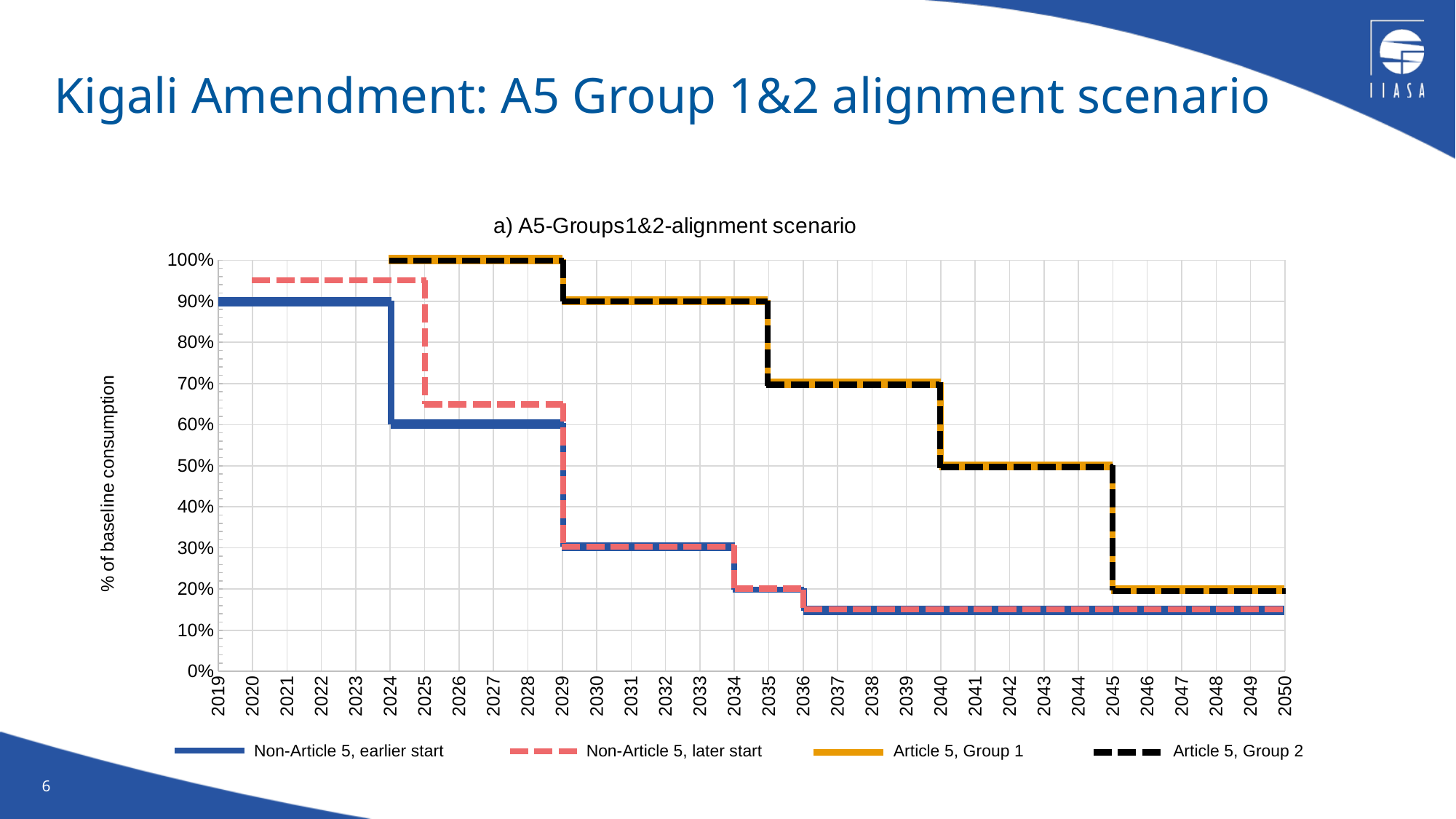
Do the values for Article 5, Group 2 rise or fall from 2024 to 2050? fall How many series does the legend list? 4 Is the value for Non-Article 5, later start in 2021 greater or less than 90%? greater What is the value for Non-Article 5, earlier start in 2031? 30% What is the label of the vertical axis? % of baseline consumption What is the value for Non-Article 5, earlier start in 2026? 60% Is the value for Non-Article 5, earlier start in 2045 greater or less than 20%? less What is the value for Article 5, Group 2 in 2042? 50% What kind of chart is shown on the slide? line chart What is the title of the chart? a) A5-Groups1&2-alignment scenario What is the value for Article 5, Group 1 in 2030? 90% In 2030, which is larger: Article 5, Group 1 or Non-Article 5, earlier start? Article 5, Group 1